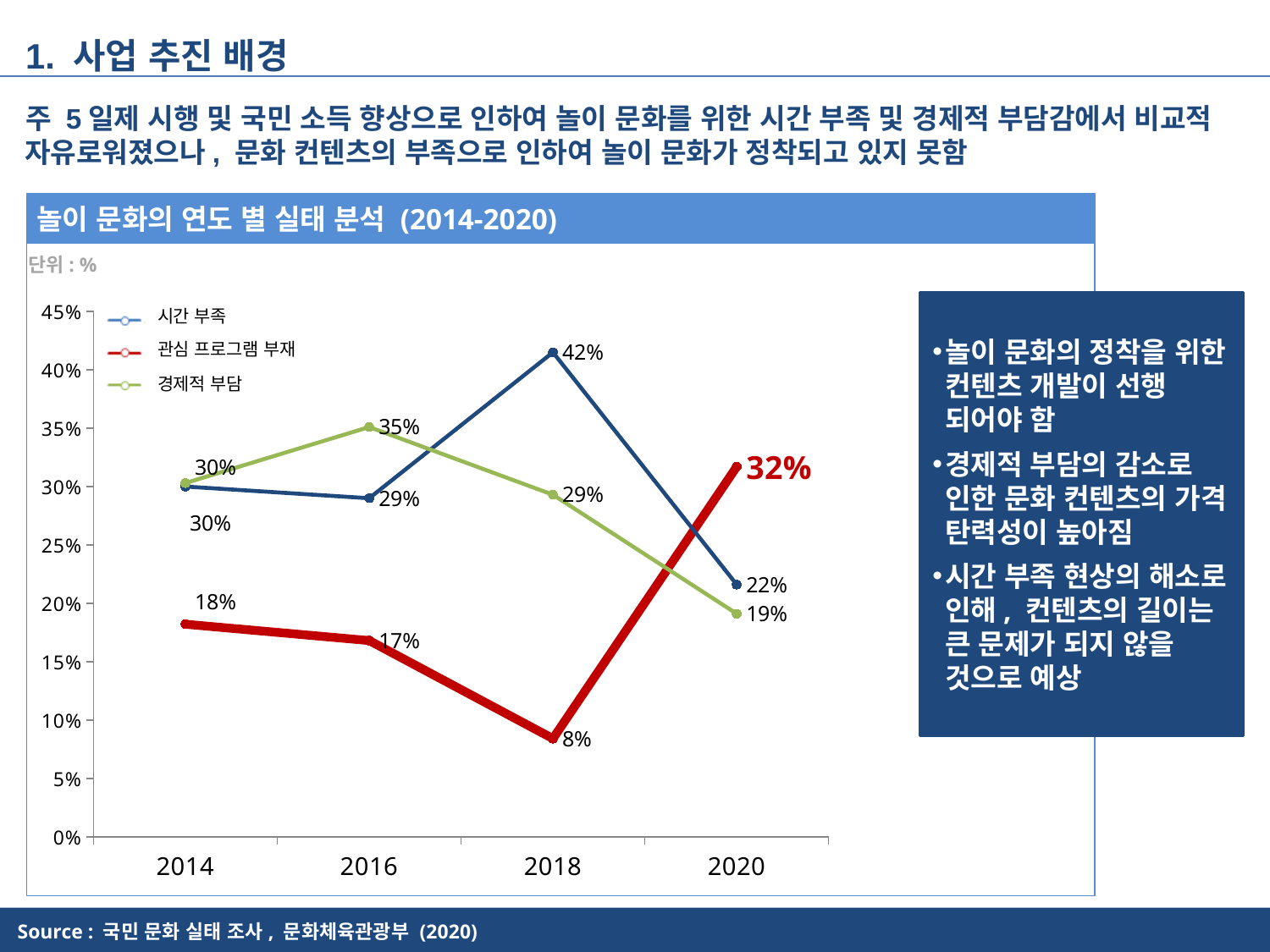
In which year is the value for 시간 부족 highest? 2018 What is the difference between the 시간 부족 value in 2018 and its value in 2020? 20% In which year is the value for 관심 프로그램 부재 lowest? 2018 What is the title of the chart? 놀이 문화의 연도 별 실태 분석 (2014-2020) How many years are plotted along the x axis of the chart? 4 Does the value for 경제적 부담 rise or fall from 2016 to 2020? fall What is the value for 경제적 부담 in 2016? 35% What is the value for 시간 부족 in 2018? 42% Which is larger in 2020, the value for 관심 프로그램 부재 or the value for 경제적 부담? 관심 프로그램 부재 What kind of chart is shown on the slide? line chart How many series does the chart legend list? 3 What is the value for 관심 프로그램 부재 in 2020? 32%